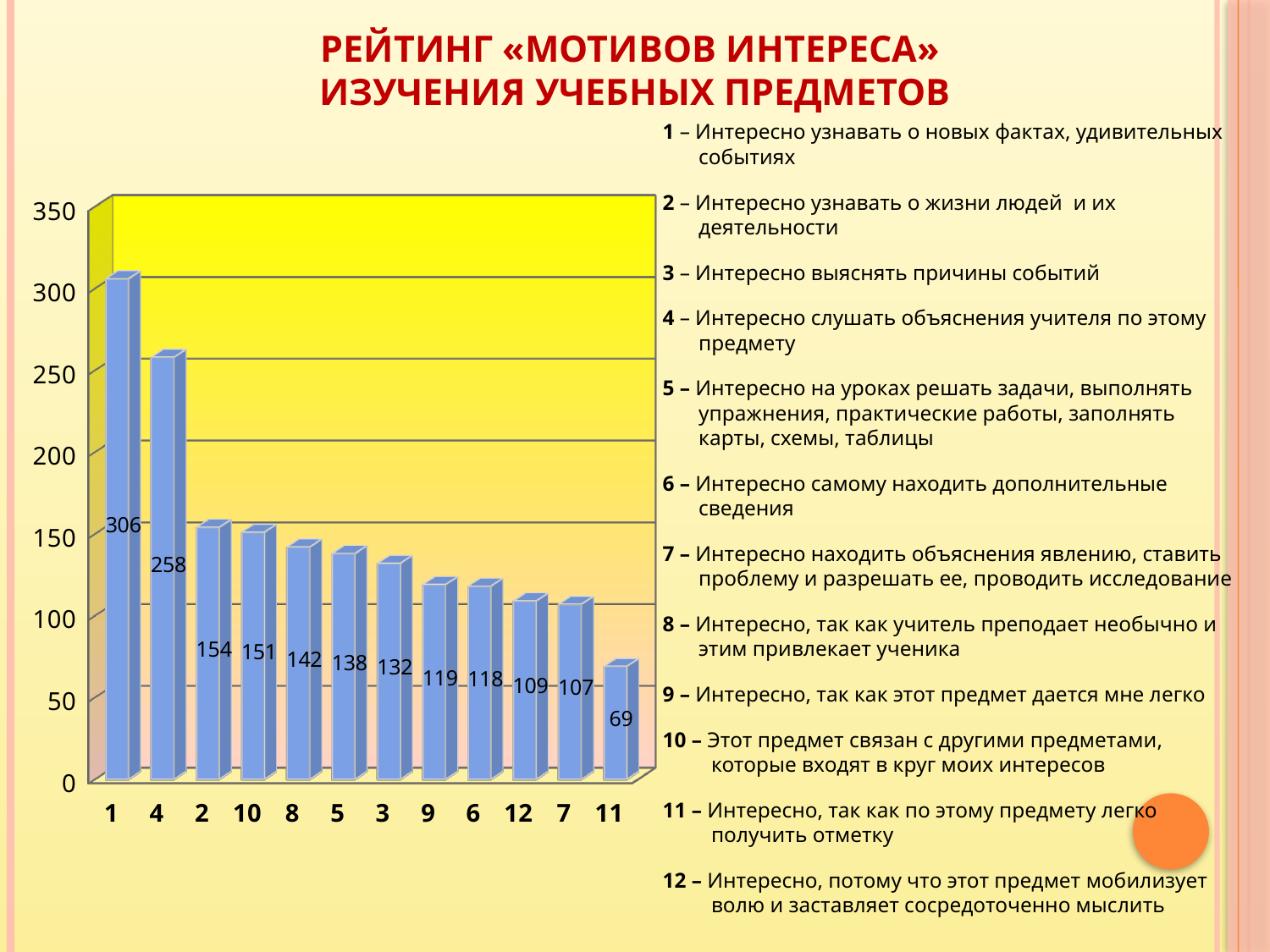
What is the value for category 12? 109 What is the difference between the values for category 1 and category 4? 48 How many bars are shown in the chart? 12 What is the difference between the values for category 2 and category 11? 85 What is the value for category 1? 306 Which category has the highest value? 1 Which is larger, the value for category 8 or the value for category 3? category 8 Which category has the lowest value? 11 Do the values rise or fall from left to right along the x axis? fall What kind of chart is shown on the slide? bar chart What is the value for category 10? 151 What is the value for category 11? 69